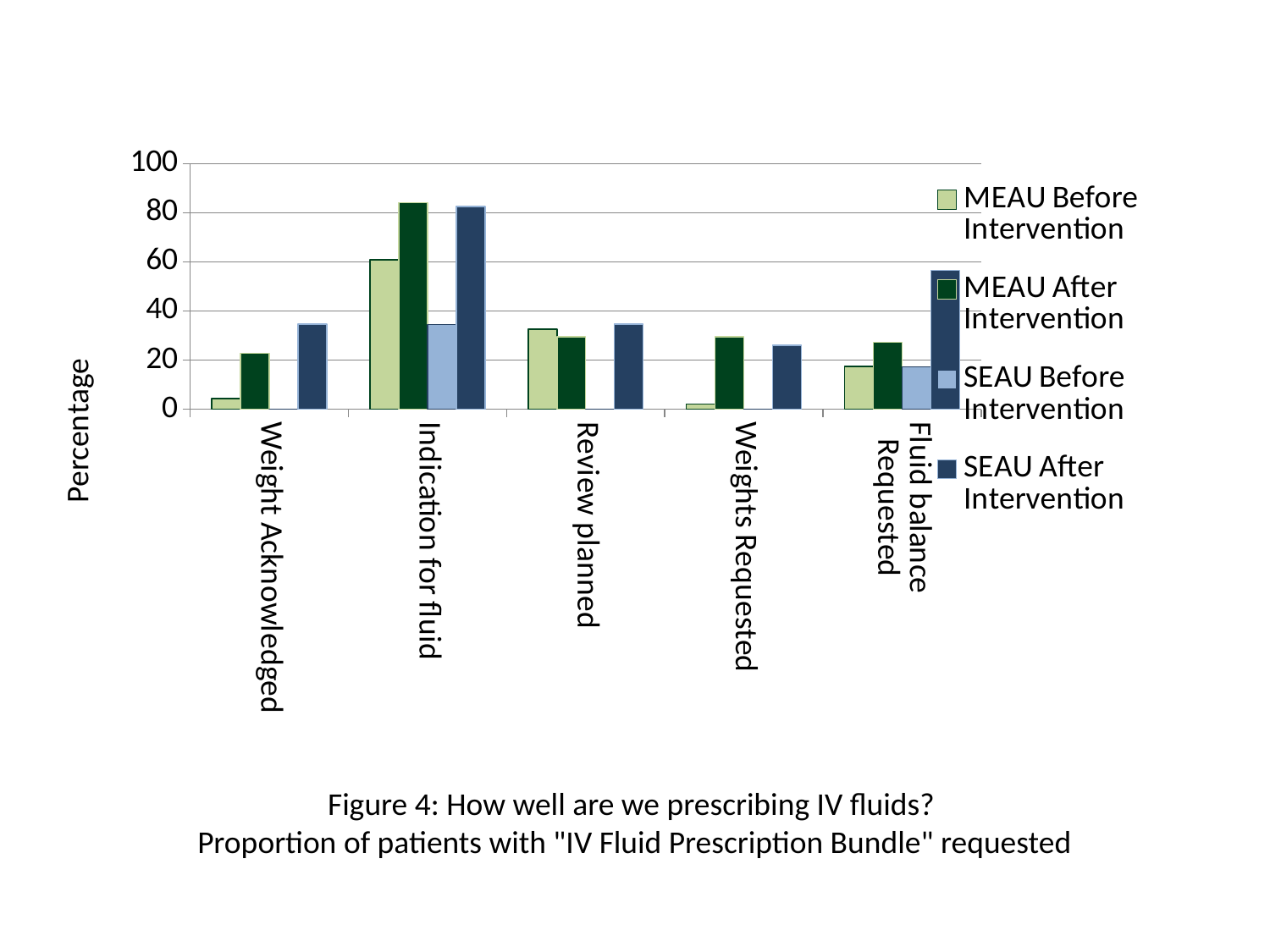
Which category has the highest value for SEAU After Intervention? Indication for fluid For Fluid balance Requested, which is larger: MEAU After Intervention or SEAU After Intervention? SEAU After Intervention How many categories are shown on the x axis of the chart? 5 Is the MEAU Before Intervention value for Weights Requested greater or less than 20? less Which category has the highest value for MEAU After Intervention? Indication for fluid Is the SEAU After Intervention value for Fluid balance Requested greater or less than 40? greater What kind of chart is shown on the slide? bar chart Is the SEAU After Intervention value for Weight Acknowledged greater or less than 20? greater What is the label on the vertical axis of the chart? Percentage For Indication for fluid, which is larger: MEAU Before Intervention or SEAU Before Intervention? MEAU Before Intervention How many series does the chart's legend list? 4